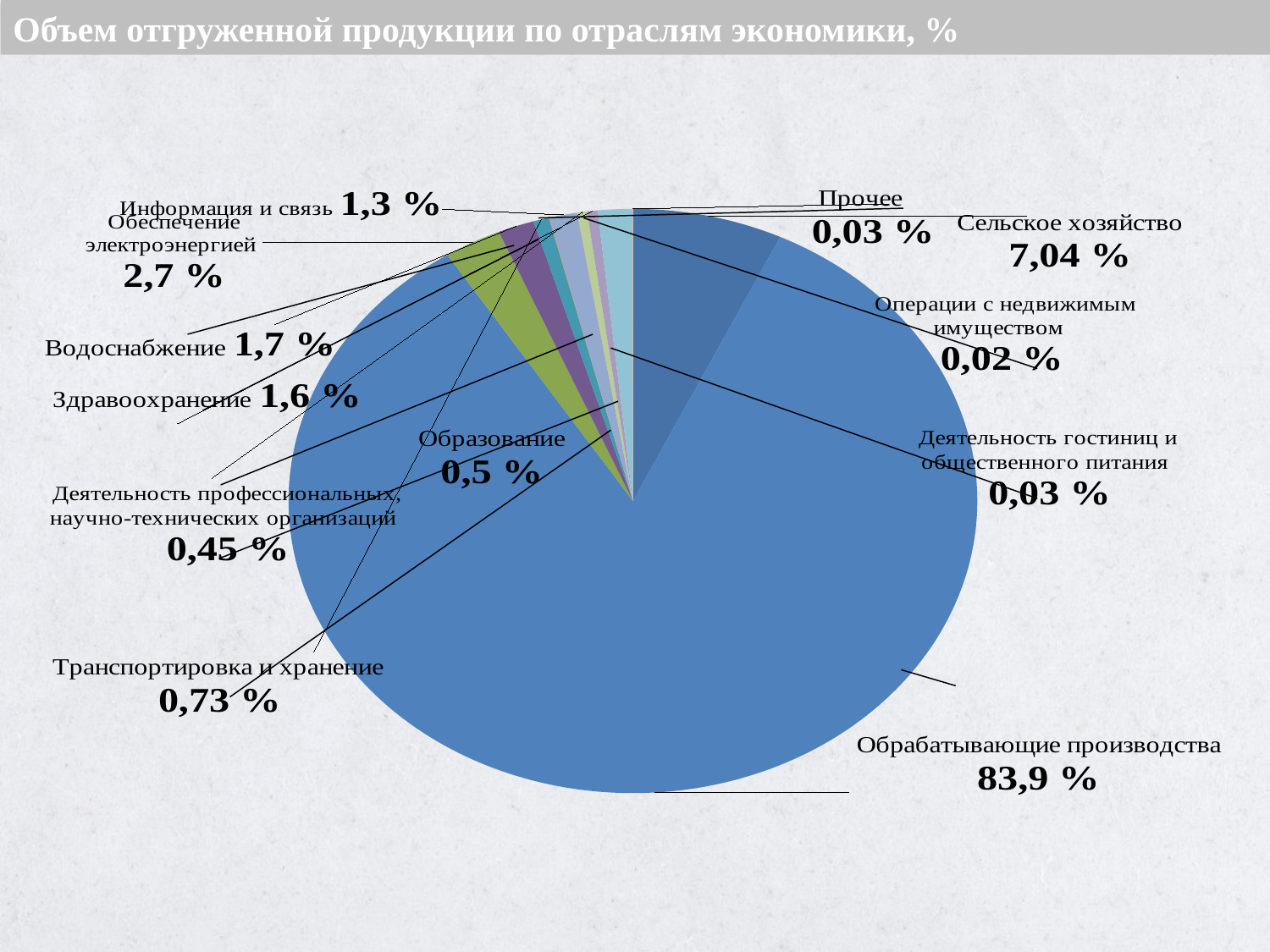
What is the title of the chart? Объем отгруженной продукции по отраслям экономики, % Which is larger, the value for Здравоохранение or the value for Информация и связь? Здравоохранение What is the value for Сельское хозяйство? 7,04 % What is the difference between the values for Обеспечение электроэнергией and Водоснабжение? 1 % What is the value for Обеспечение электроэнергией? 2,7 % Which category has the smallest share of the pie? Операции с недвижимым имуществом Which category has the largest share of the pie? Обрабатывающие производства What is the value for Транспортировка и хранение? 0,73 % What is the difference between the values for Сельское хозяйство and Обеспечение электроэнергией? 4,34 % How many categories are shown in the pie chart? 12 What share does Обрабатывающие производства have in the pie chart? 83,9 % What kind of chart is shown on the slide? pie chart